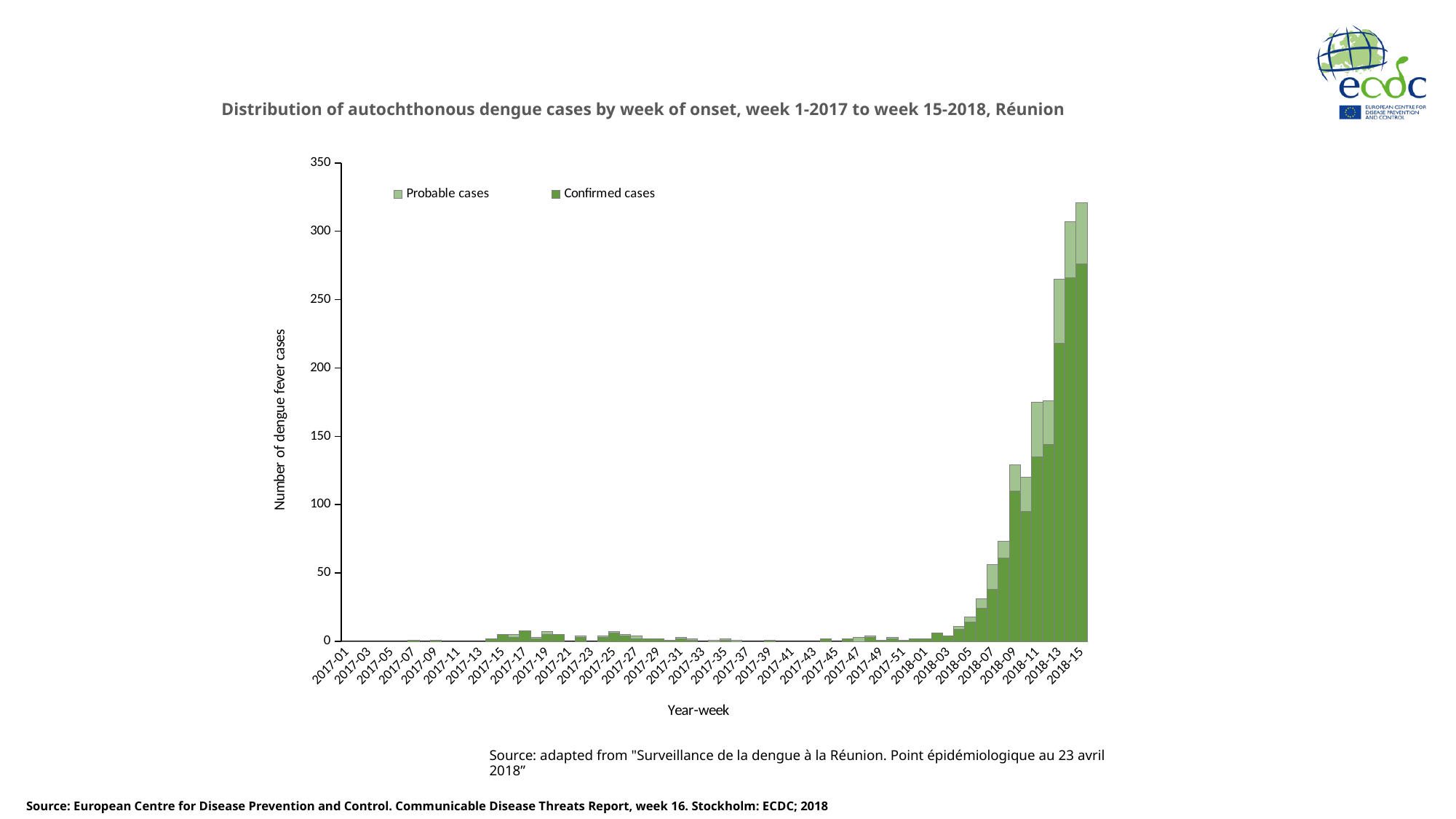
Is the total number of cases for week 2018-13 greater or less than 250? greater Is the total number of cases for week 2018-11 greater or less than 150? greater Which year-week has the highest total number of dengue cases? 2018-15 Do the weekly case counts rise or fall from week 2018-01 to week 2018-15? rise What are the two series named in the legend? Probable cases and Confirmed cases Which week has more total cases, 2018-11 or 2018-13? 2018-13 Is the total number of cases for week 2018-07 greater or less than 100? less How many series does the legend list? 2 What kind of chart is shown on the slide? Stacked bar chart What is the label of the y axis? Number of dengue fever cases